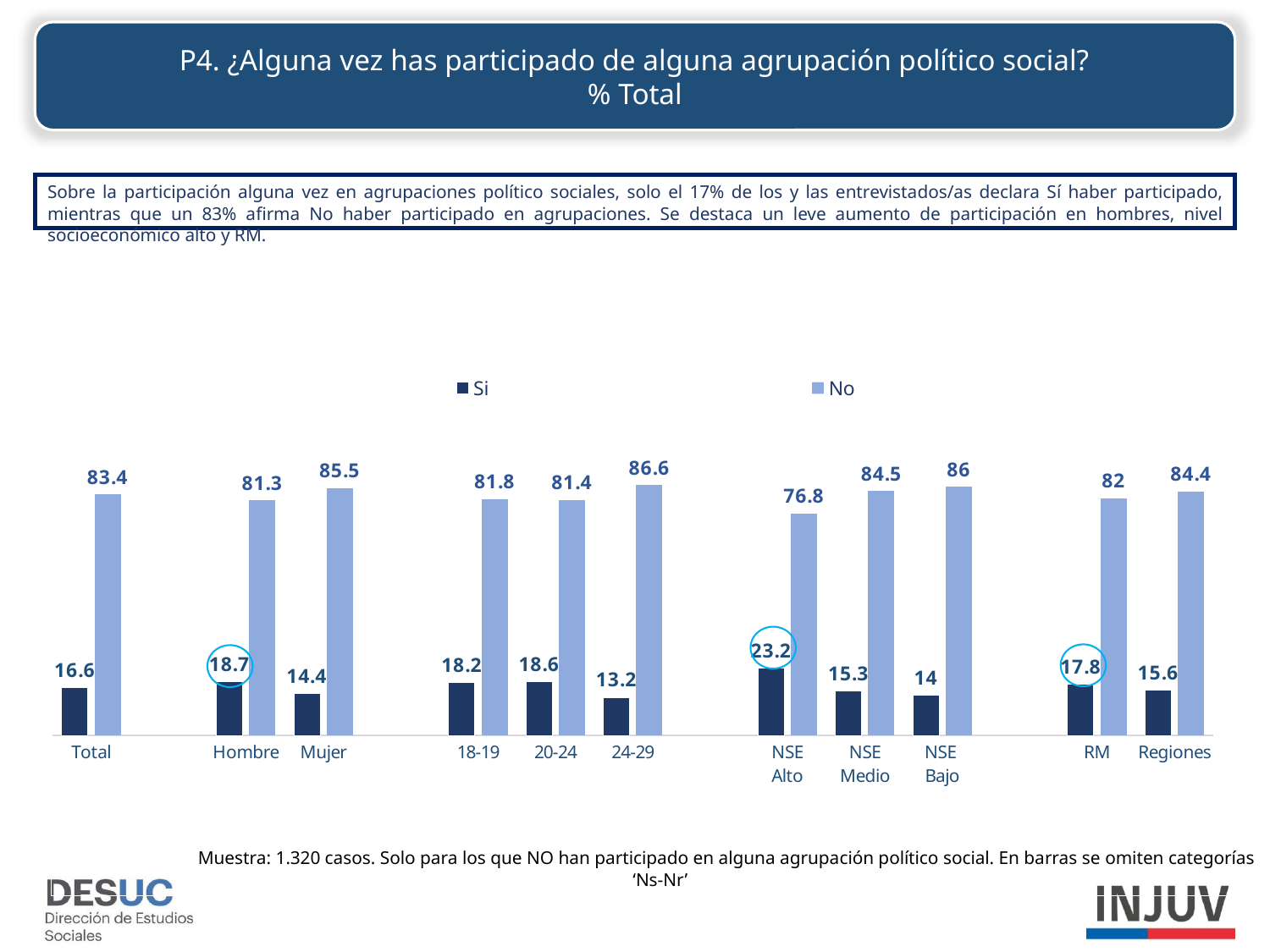
Which category has the highest 'Si' value? NSE Alto What is the difference between the 'No' values for NSE Bajo and NSE Alto? 9.2 How many series does the legend list? 2 What is the difference between the 'Si' values for Hombre and Mujer? 4.3 Which is larger, the 'Si' value for RM or for Regiones? RM What kind of chart is shown on the slide? Bar chart Which category has the lowest 'No' value? NSE Alto What is the value of the 'Si' series for Total? 16.6 Which category has the lowest 'Si' value? 24-29 What is the value of the 'Si' series for NSE Alto? 23.2 How many categories are shown on the x axis? 11 What is the value of the 'No' series for Mujer? 85.5